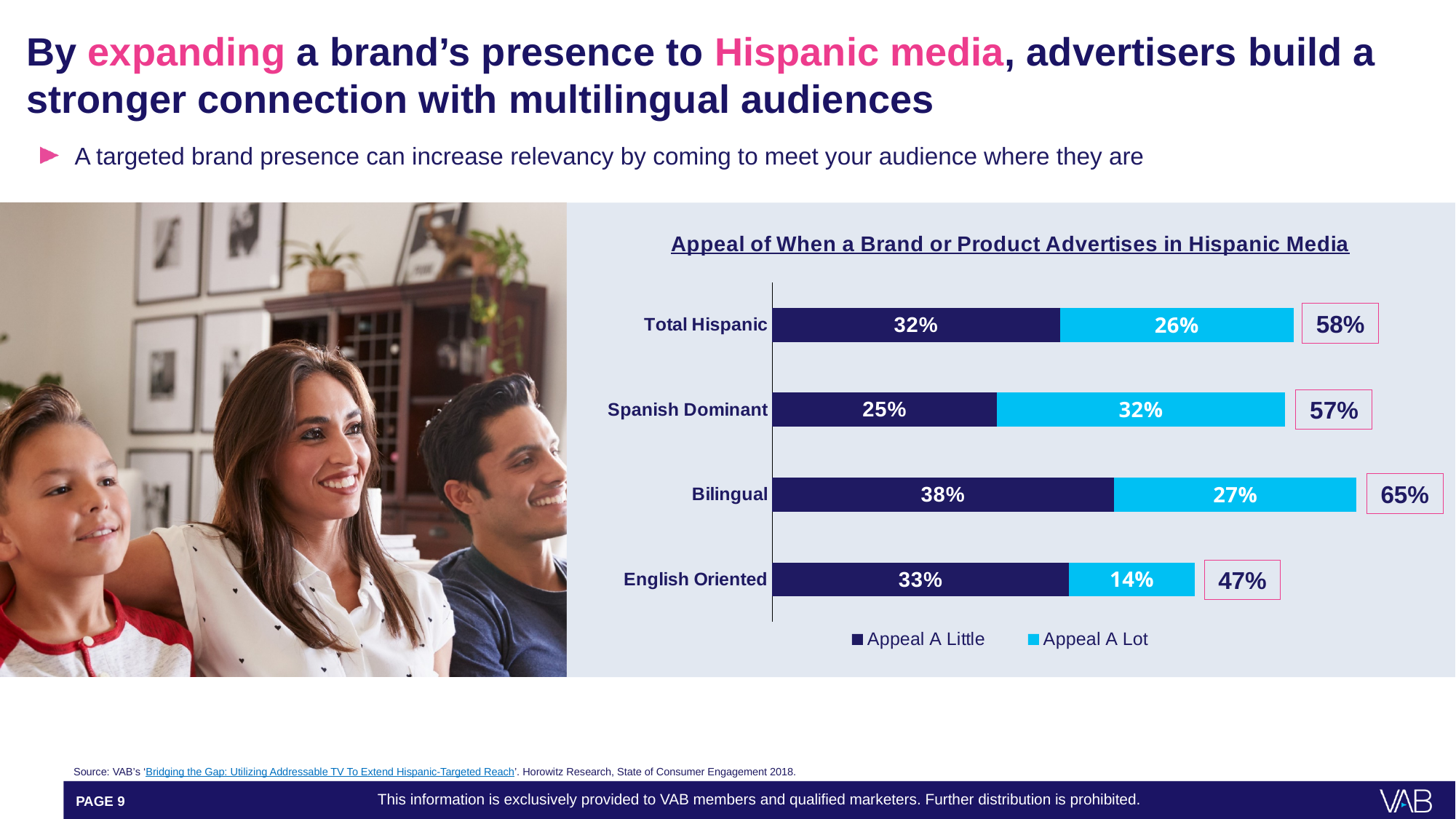
What is the 'Appeal A Lot' value for Spanish Dominant? 32% What is the 'Appeal A Little' value for Bilingual? 38% Which category has the lowest 'Appeal A Little' value? Spanish Dominant What is the total of the stacked bar for Bilingual? 65% What is the total of the stacked bar for English Oriented? 47% What kind of chart is shown on the slide? Stacked bar chart Which is larger: the 'Appeal A Little' value for Total Hispanic or for English Oriented? English Oriented How many series does the legend list? 2 Which category has the highest 'Appeal A Lot' value? Spanish Dominant What is the difference between the 'Appeal A Lot' values for Bilingual and English Oriented? 13% How many categories are shown in the chart? 4 What is the 'Appeal A Lot' value for English Oriented? 14%